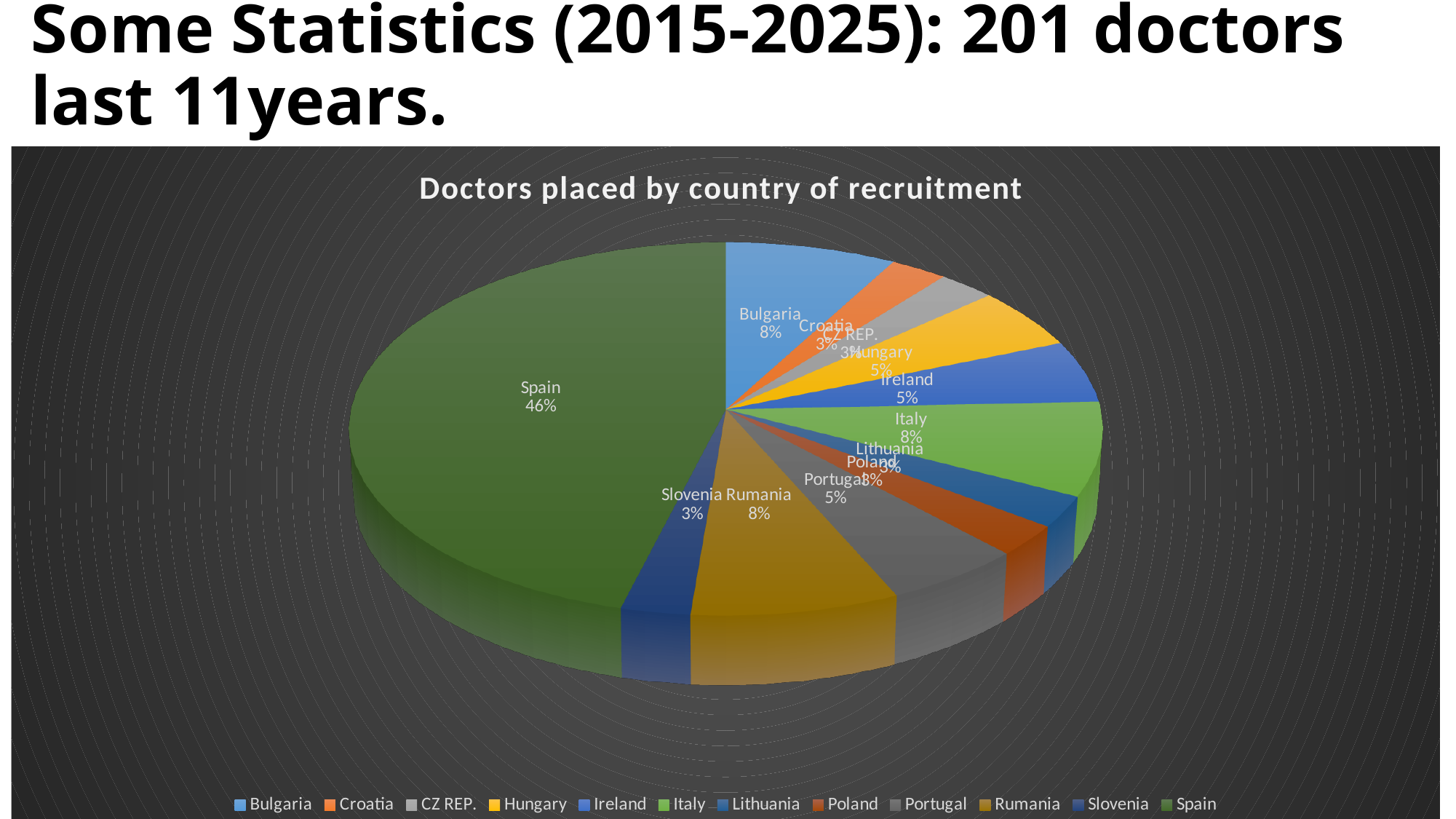
What share of doctors placed were recruited from Bulgaria? 8% What share of doctors placed were recruited from Portugal? 5% What share of doctors placed were recruited from Hungary? 5% What is the difference in percentage points between the share for Spain and the share for Rumania? 38 What kind of chart is shown on the slide? pie chart What is the title of the chart? Doctors placed by country of recruitment How many countries are listed in the legend? 12 Which is larger, the share for Italy or the share for Lithuania? Italy Which country has the largest slice of the pie? Spain What is the combined share of Ireland and Italy? 13%